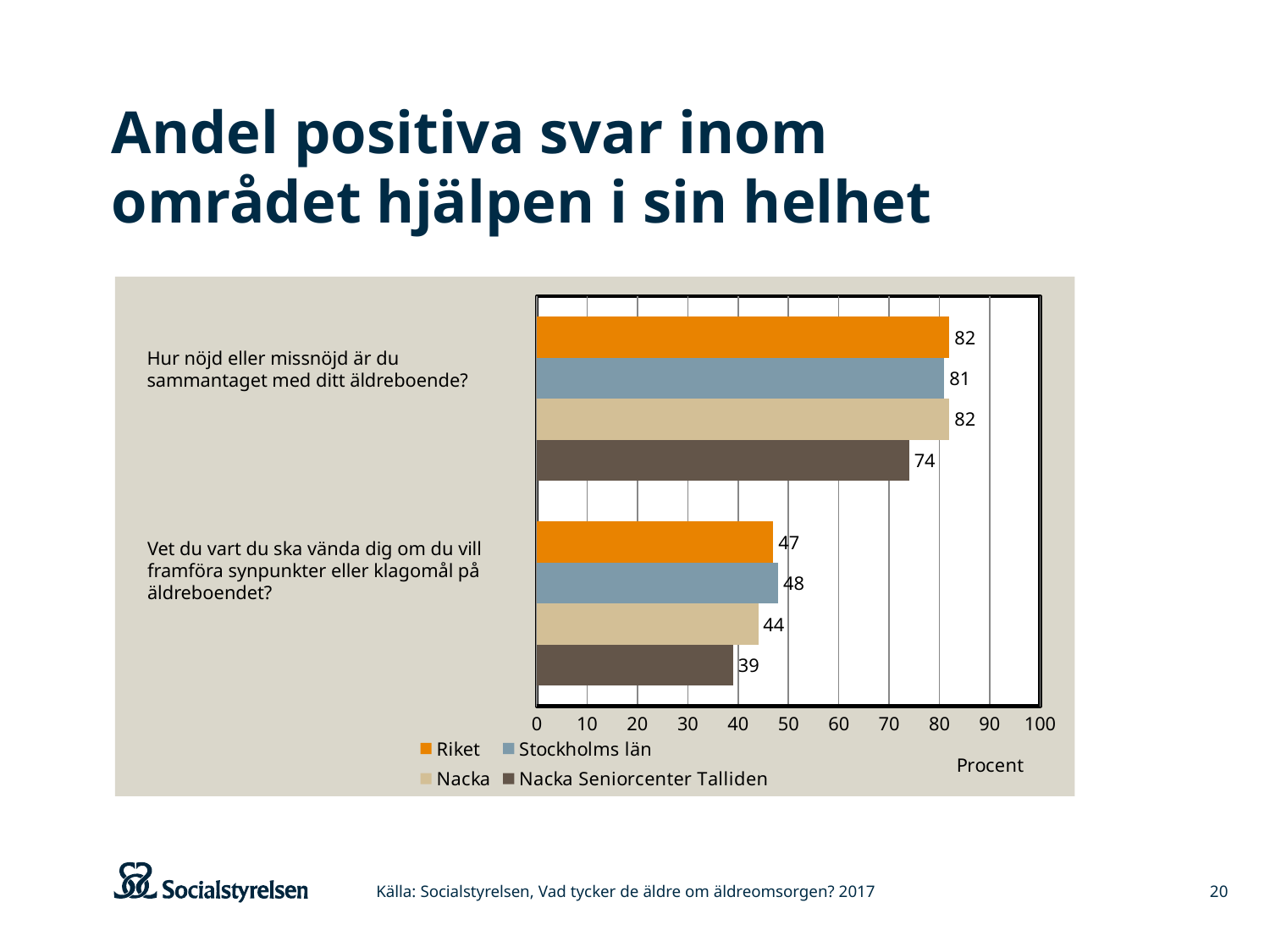
Which series has the lowest value on the question "Vet du vart du ska vända dig om du vill framföra synpunkter eller klagomål på äldreboendet?"? Nacka Seniorcenter Talliden What is the value for Nacka Seniorcenter Talliden on the question "Hur nöjd eller missnöjd är du sammantaget med ditt äldreboende?"? 74 How many series does the legend list? 4 What is the difference between the Riket value and the Nacka Seniorcenter Talliden value on the question "Hur nöjd eller missnöjd är du sammantaget med ditt äldreboende?"? 8 What kind of chart is shown on the slide? Bar chart How many questions (categories) are shown on the chart? 2 What is the value for Stockholms län on the question "Vet du vart du ska vända dig om du vill framföra synpunkter eller klagomål på äldreboendet?"? 48 On the question "Vet du vart du ska vända dig om du vill framföra synpunkter eller klagomål på äldreboendet?", which is larger: the value for Nacka or the value for Nacka Seniorcenter Talliden? Nacka Is the value for Nacka Seniorcenter Talliden on the question "Hur nöjd eller missnöjd är du sammantaget med ditt äldreboende?" greater or less than 70? greater What is the label of the horizontal axis? Procent What is the difference between the Stockholms län value and the Nacka value on the question "Vet du vart du ska vända dig om du vill framföra synpunkter eller klagomål på äldreboendet?"? 4 What is the value for Riket on the question "Hur nöjd eller missnöjd är du sammantaget med ditt äldreboende?"? 82